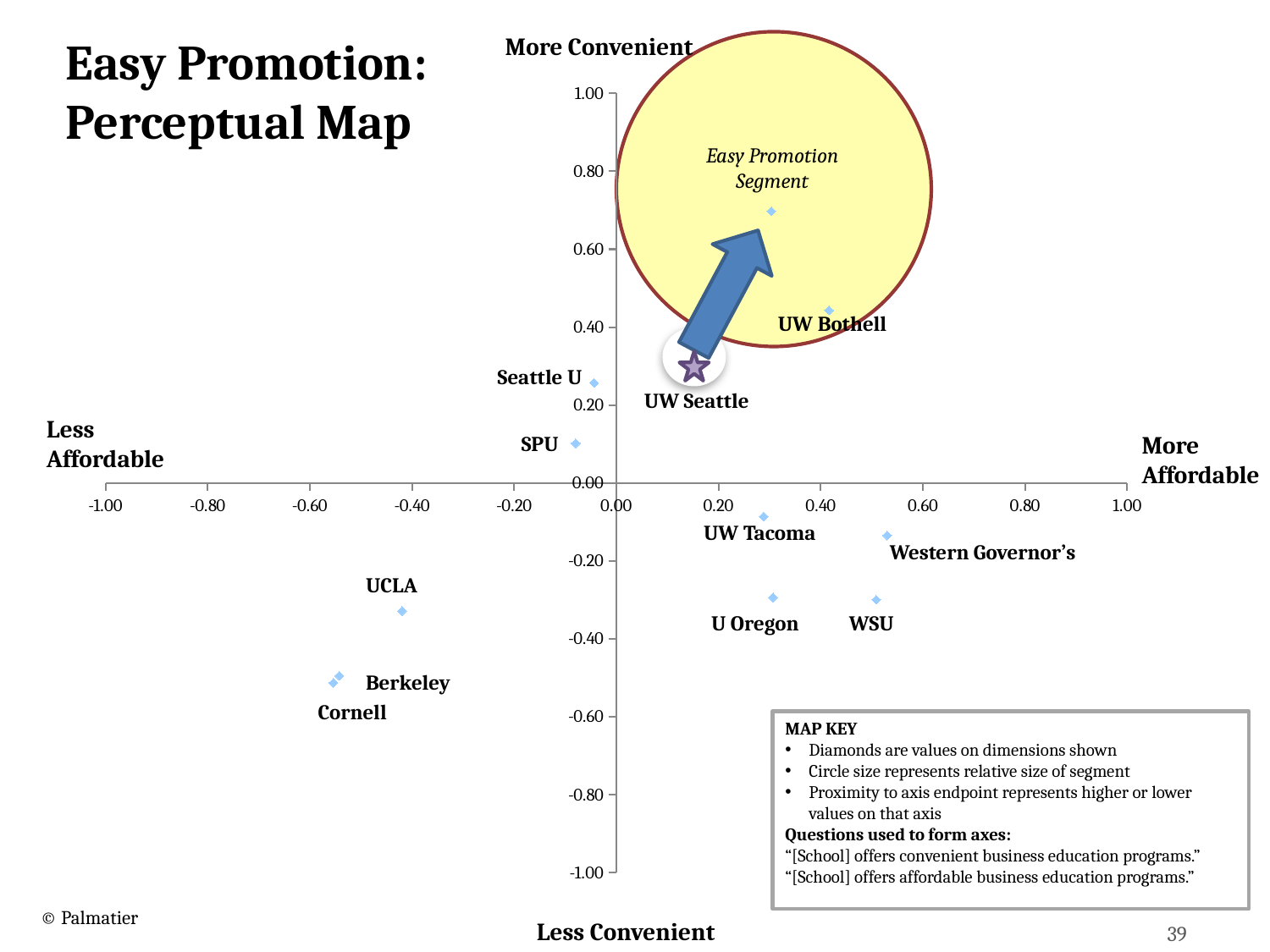
Which is plotted further toward More Affordable, UCLA or WSU? WSU Is the affordability value for SPU greater or less than 0.00? less Which school is plotted highest on the convenience (vertical) axis? UW Bothell What kind of chart is shown on the slide? Scatter plot (perceptual map) Is the affordability value for UCLA greater or less than -0.20? less Is the affordability value for Western Governor's greater or less than 0.40? greater What label appears at the top end of the vertical axis? More Convenient What is the title of the slide's chart? Easy Promotion: Perceptual Map Which is plotted higher on the convenience axis, UW Bothell or Seattle U? UW Bothell How many schools are labeled on the perceptual map? 11